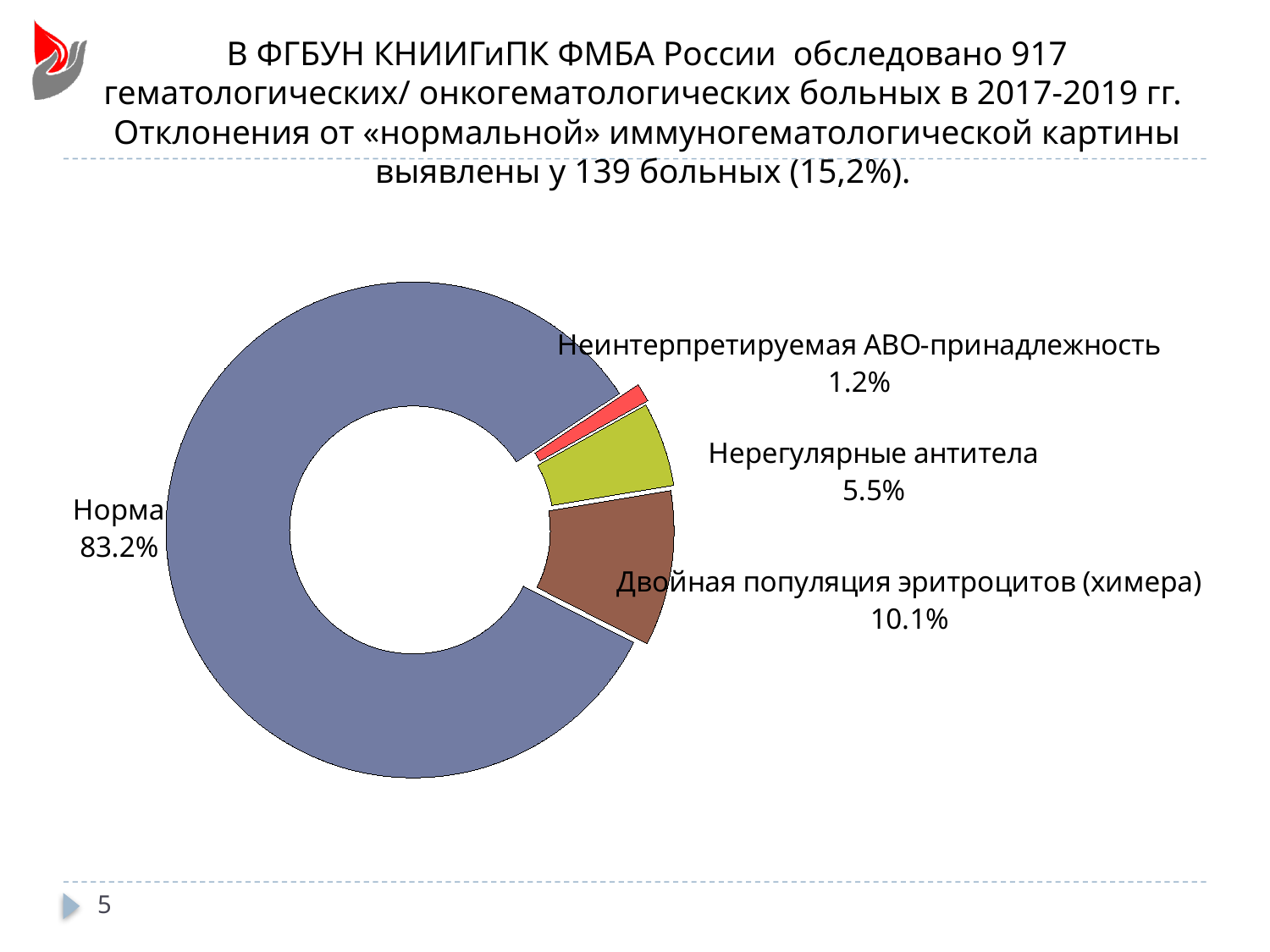
Which is larger: "Нерегулярные антитела" or "Неинтерпретируемая АВО-принадлежность"? Нерегулярные антитела Which category has the smallest slice? Неинтерпретируемая АВО-принадлежность What is the value shown for "Двойная популяция эритроцитов (химера)"? 10.1% What kind of chart is shown on the slide? Doughnut (pie) chart What colour is the "Нерегулярные антитела" slice? Yellow-green How many categories are shown in the chart? 4 What is the difference between the values for "Двойная популяция эритроцитов (химера)" and "Нерегулярные антитела"? 4.6% What is the value shown for "Нерегулярные антитела"? 5.5% Which category has the largest slice? Норма What is the value shown for "Неинтерпретируемая АВО-принадлежность"? 1.2% What share of the chart does the "Норма" slice represent? 83.2% What is the difference between the values for "Норма" and "Двойная популяция эритроцитов (химера)"? 73.1%